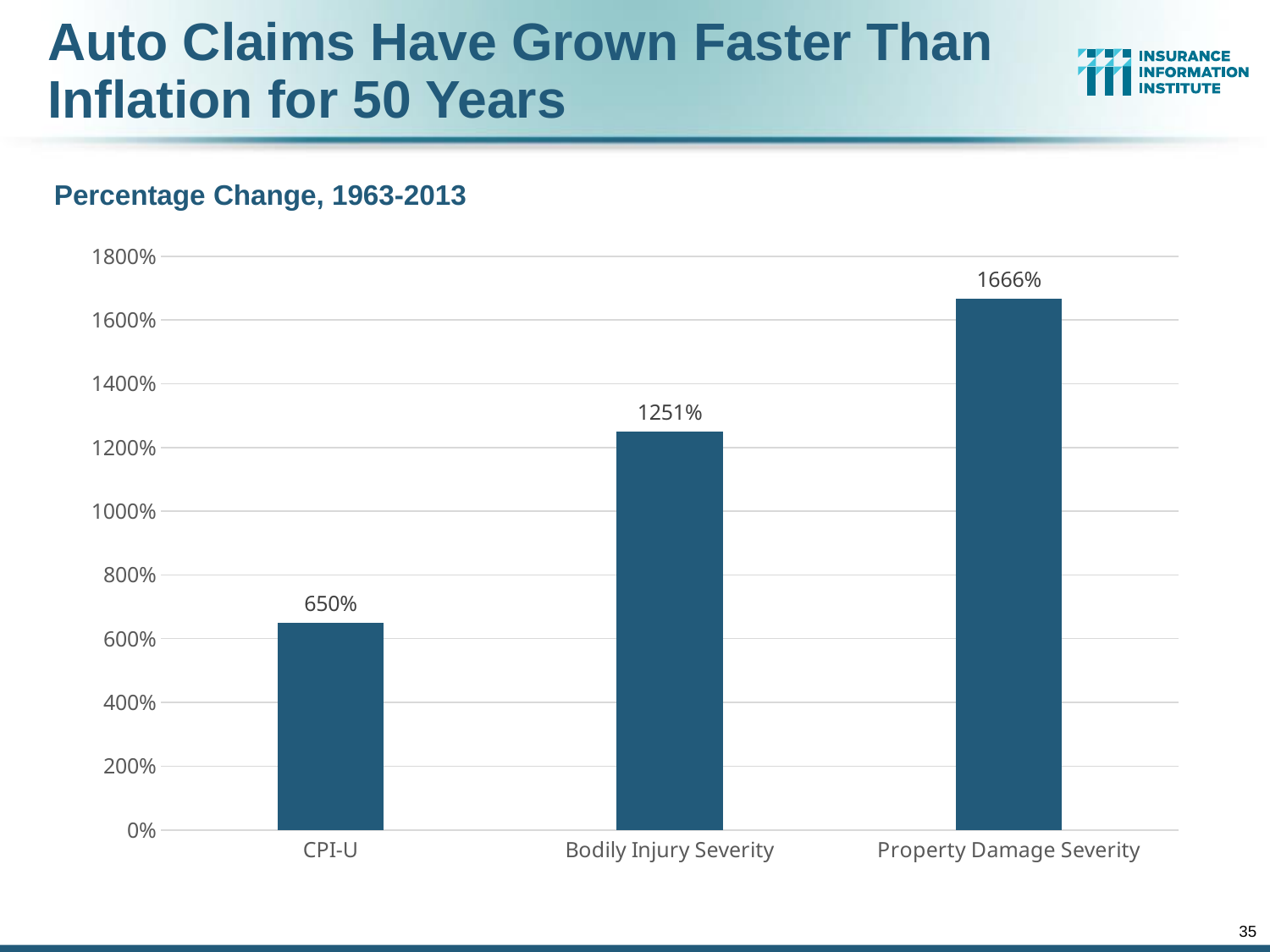
What is the difference between the percentage change for Bodily Injury Severity and CPI-U? 601% What is the percentage change for Bodily Injury Severity? 1251% What is the percentage change for CPI-U? 650% How many categories are shown in the chart? 3 What is the difference between the percentage change for Property Damage Severity and Bodily Injury Severity? 415% Which category has the lowest percentage change? CPI-U What is the percentage change for Property Damage Severity? 1666% Is the value for Bodily Injury Severity greater or less than 1000%? greater Which category has the highest percentage change? Property Damage Severity What is the subtitle shown above the chart? Percentage Change, 1963-2013 What kind of chart is shown on the slide? Bar chart Which is larger, the percentage change for Bodily Injury Severity or for CPI-U? Bodily Injury Severity